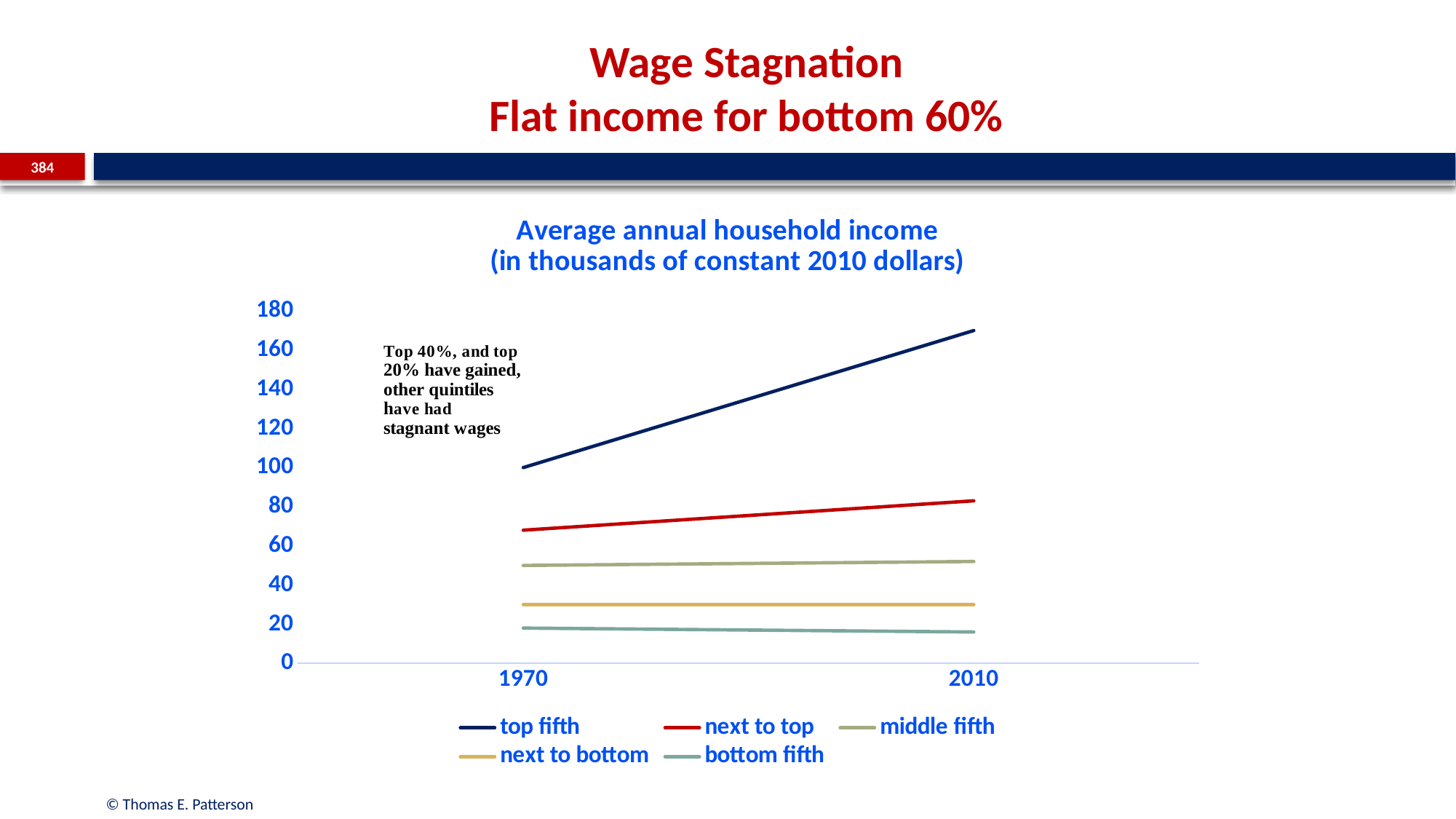
Is the value for bottom fifth in 2010 greater or less than 20? less Is the value for next to top in 1970 greater or less than 60? greater Which series has the lowest value in 2010? bottom fifth Which series has the highest value in 2010? top fifth What is the title of the chart? Average annual household income (in thousands of constant 2010 dollars) Does the top fifth line rise or fall from 1970 to 2010? rise Is the value for top fifth in 2010 greater or less than 160? greater What kind of chart is shown on the slide? line chart In 2010, which is larger: next to top or middle fifth? next to top How many series does the legend list? 5 How many years are shown on the x axis? 2